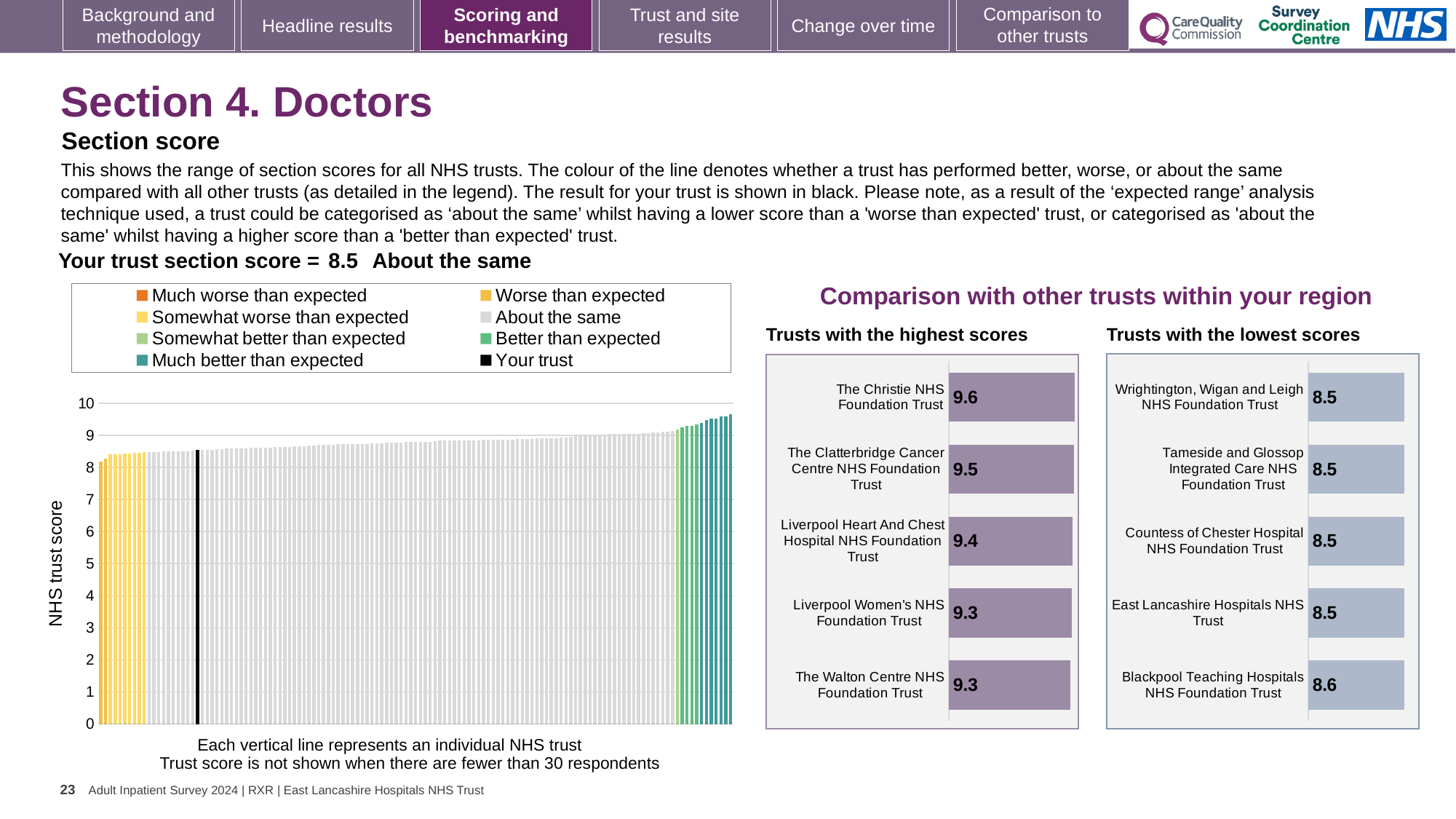
How many trusts are shown in the 'Trusts with the lowest scores' chart? 5 In the 'Trusts with the highest scores' chart, what is the score for Liverpool Heart And Chest Hospital NHS Foundation Trust? 9.4 In the 'Trusts with the lowest scores' chart, what is the score for Blackpool Teaching Hospitals NHS Foundation Trust? 8.6 In the 'Trusts with the highest scores' chart, what is the difference between the scores of The Christie NHS Foundation Trust and The Walton Centre NHS Foundation Trust? 0.3 In the 'Trusts with the highest scores' chart, which has the larger score: The Christie NHS Foundation Trust or The Clatterbridge Cancer Centre NHS Foundation Trust? The Christie NHS Foundation Trust What type of chart is the main chart on the left showing NHS trust scores? Bar chart In the 'Trusts with the highest scores' chart, what is the score for The Christie NHS Foundation Trust? 9.6 In the main chart of NHS trust scores on the left, is the value of the highest bar greater or less than 9? greater In the 'Trusts with the lowest scores' chart, which trust has the highest score? Blackpool Teaching Hospitals NHS Foundation Trust In the 'Trusts with the lowest scores' chart, what is the score for East Lancashire Hospitals NHS Trust? 8.5 How many entries does the legend of the main chart on the left list? 8 In the 'Trusts with the highest scores' chart, which trust has the highest score? The Christie NHS Foundation Trust